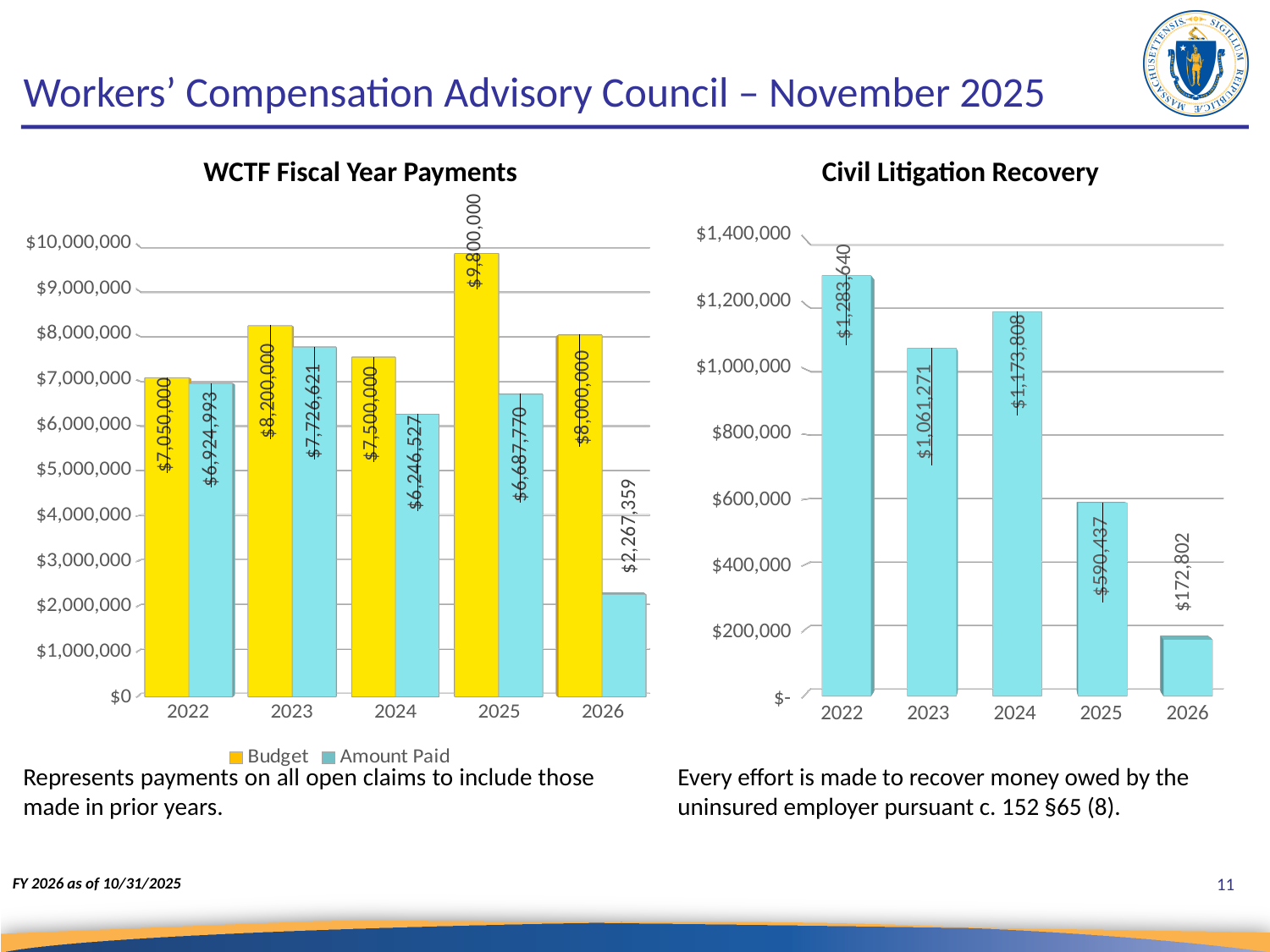
In the WCTF Fiscal Year Payments chart, what is the difference between the Budget and the Amount Paid for 2024? $1,253,473 In the WCTF Fiscal Year Payments chart, which is larger: the Amount Paid for 2023 or the Amount Paid for 2025? Amount Paid for 2023 How many years are shown on the x axis of the Civil Litigation Recovery chart? 5 In the Civil Litigation Recovery chart, which year has the lowest value? 2026 In the Civil Litigation Recovery chart, which year has the highest value? 2022 In the Civil Litigation Recovery chart, what is the difference between the 2024 and 2025 values? $583,371 In the WCTF Fiscal Year Payments chart, which year has the highest Budget? 2025 In the Civil Litigation Recovery chart, what is the value for 2023? $1,061,271 In the WCTF Fiscal Year Payments chart, what is the Budget value for 2025? $9,800,000 In the WCTF Fiscal Year Payments chart, how many series does the legend list? 2 In the WCTF Fiscal Year Payments chart, what is the Amount Paid for 2026? $2,267,359 What kind of chart is the Civil Litigation Recovery chart? Bar chart